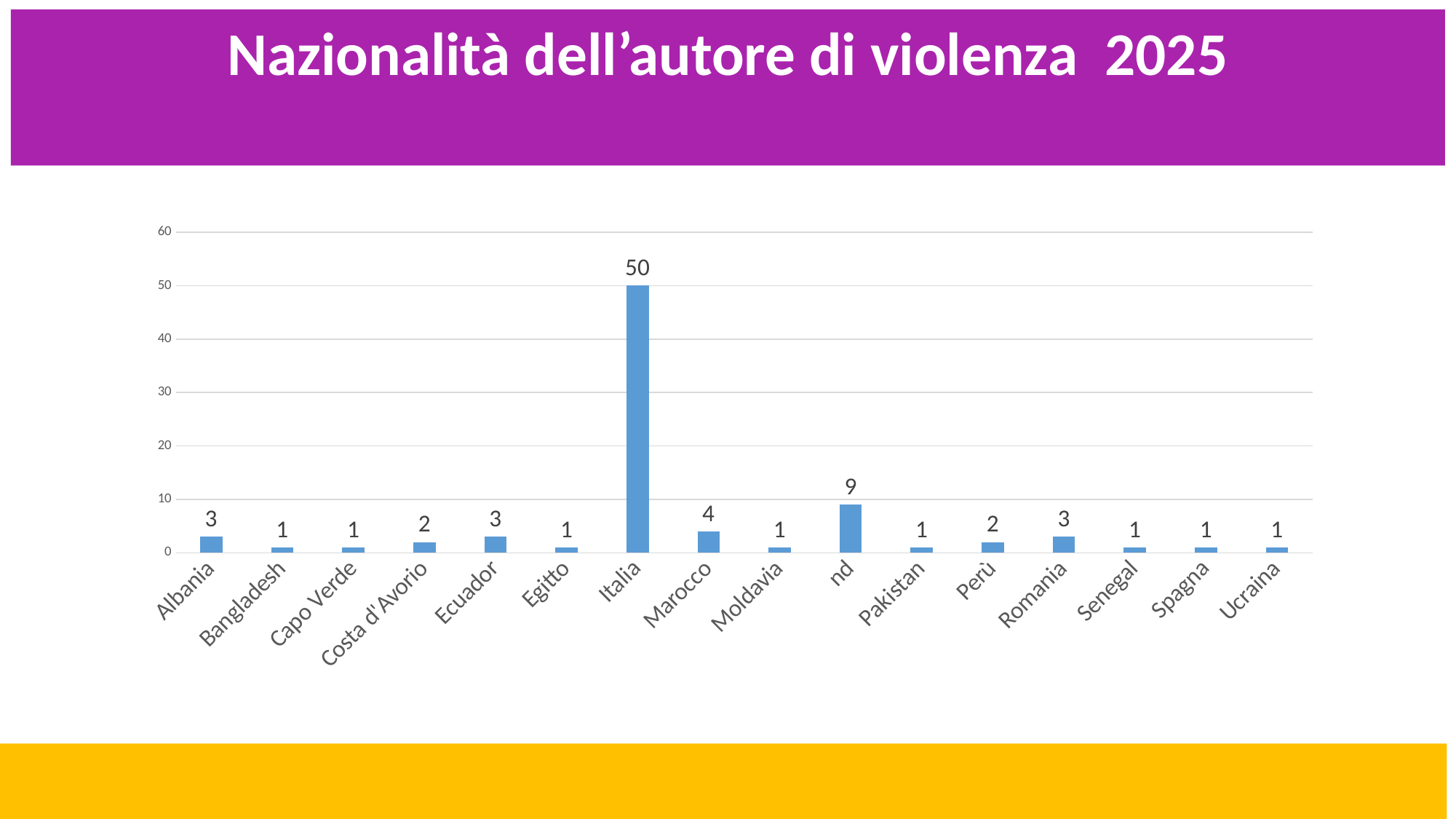
What is the value for Marocco? 4 What is the title of the slide? Nazionalità dell'autore di violenza 2025 What is the difference between the values for Marocco and Albania? 1 What is the difference between the values for Italia and nd? 41 Which is larger, the value for Romania or the value for Perù? Romania What is the value for Italia? 50 What is the value for nd? 9 Which category has the highest value? Italia How many categories are shown on the x axis? 16 Is the value for Italia greater or less than 40? greater What is the value for Costa d'Avorio? 2 What kind of chart is shown on the slide? bar chart